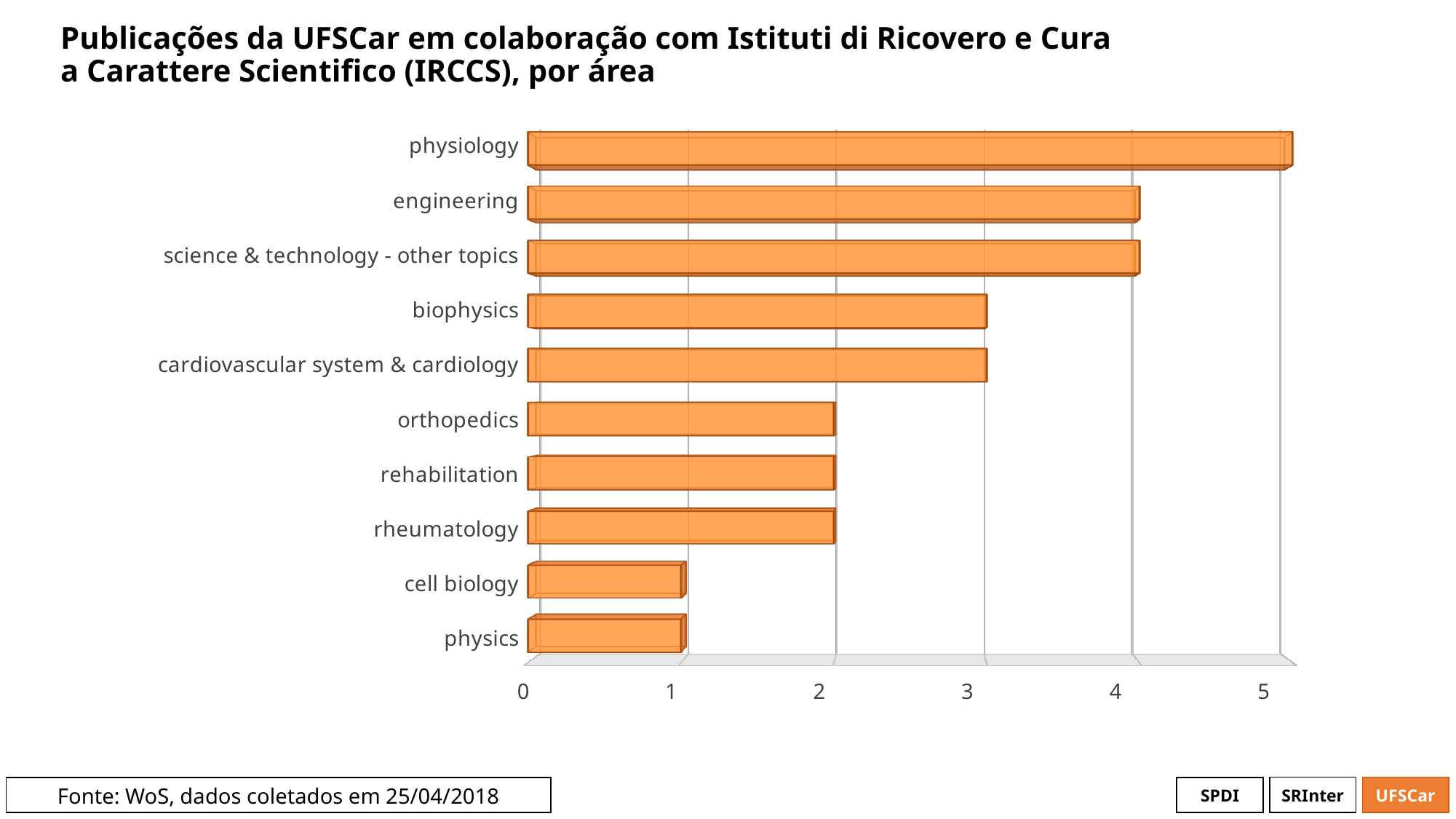
What is the value for physics? 1 Which area has the highest number of publications? physiology What is the source of the data cited at the bottom of the slide? WoS, dados coletados em 25/04/2018 What is the value for physiology? 5 What is the difference between the value for physiology and the value for physics? 4 What kind of chart is shown on the slide? bar chart Is the value for cell biology greater or less than 2? less Is the value for engineering greater or less than 3? greater What is the value for orthopedics? 2 How many areas (categories) are plotted in the chart? 10 Which is larger, the value for cardiovascular system & cardiology or the value for rehabilitation? cardiovascular system & cardiology What is the value for biophysics? 3